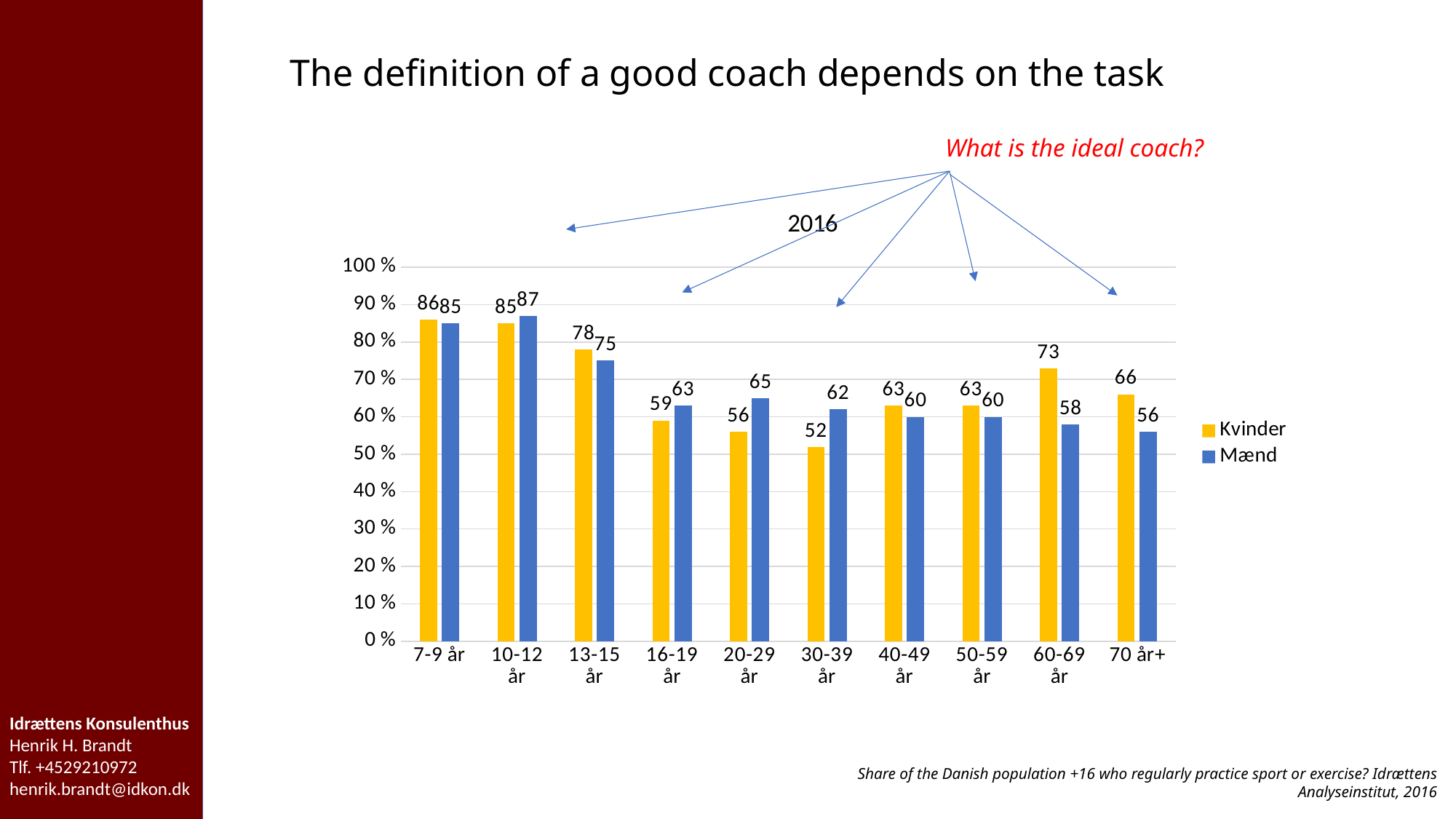
What is the title of the chart? 2016 What kind of chart is shown on the slide? Bar chart What is the value for Mænd in the 10-12 år category? 87 How many series does the legend list? 2 How many age categories are shown on the x axis? 10 Which age category has the lowest value for Kvinder? 30-39 år What is the difference between the Kvinder and Mænd values in the 60-69 år category? 15 What is the value for Mænd in the 70 år+ category? 56 What is the value for Kvinder in the 7-9 år category? 86 What is the value for Kvinder in the 30-39 år category? 52 In the 20-29 år category, which is larger: Kvinder or Mænd? Mænd Which age category has the highest value for Mænd? 10-12 år